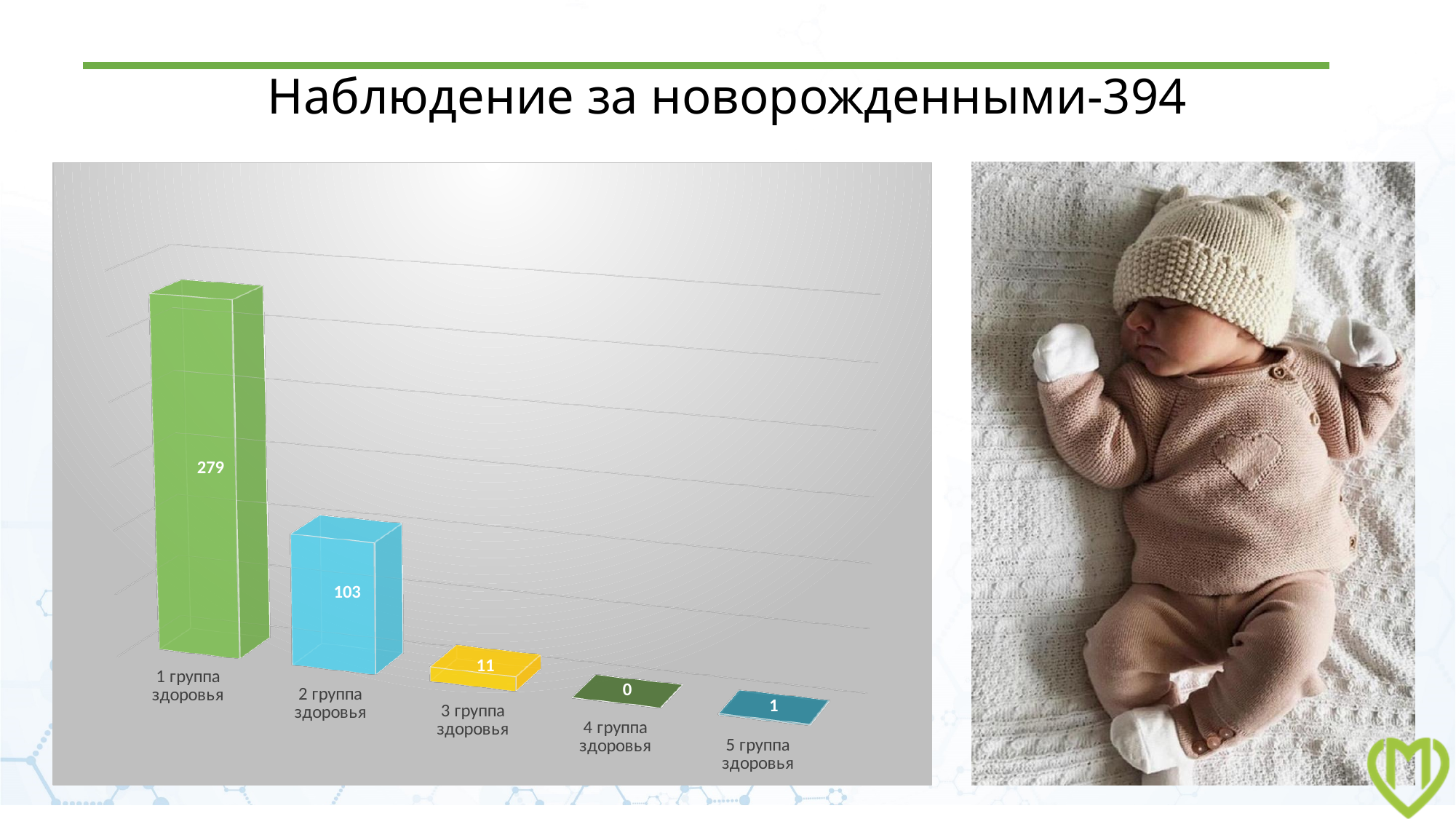
What is the difference between the values for 1 группа здоровья and 2 группа здоровья? 176 Which health group has the lowest value? 4 группа здоровья What is the value for 4 группа здоровья? 0 What is the value for 1 группа здоровья? 279 Which is larger, the value for 3 группа здоровья or 5 группа здоровья? 3 группа здоровья What is the value for 3 группа здоровья? 11 What kind of chart is shown on the slide? bar chart How many health group categories are shown in the chart? 5 What is the value for 5 группа здоровья? 1 Do the values rise or fall from 1 группа здоровья to 4 группа здоровья? fall Which health group has the highest value? 1 группа здоровья What is the value for 2 группа здоровья? 103